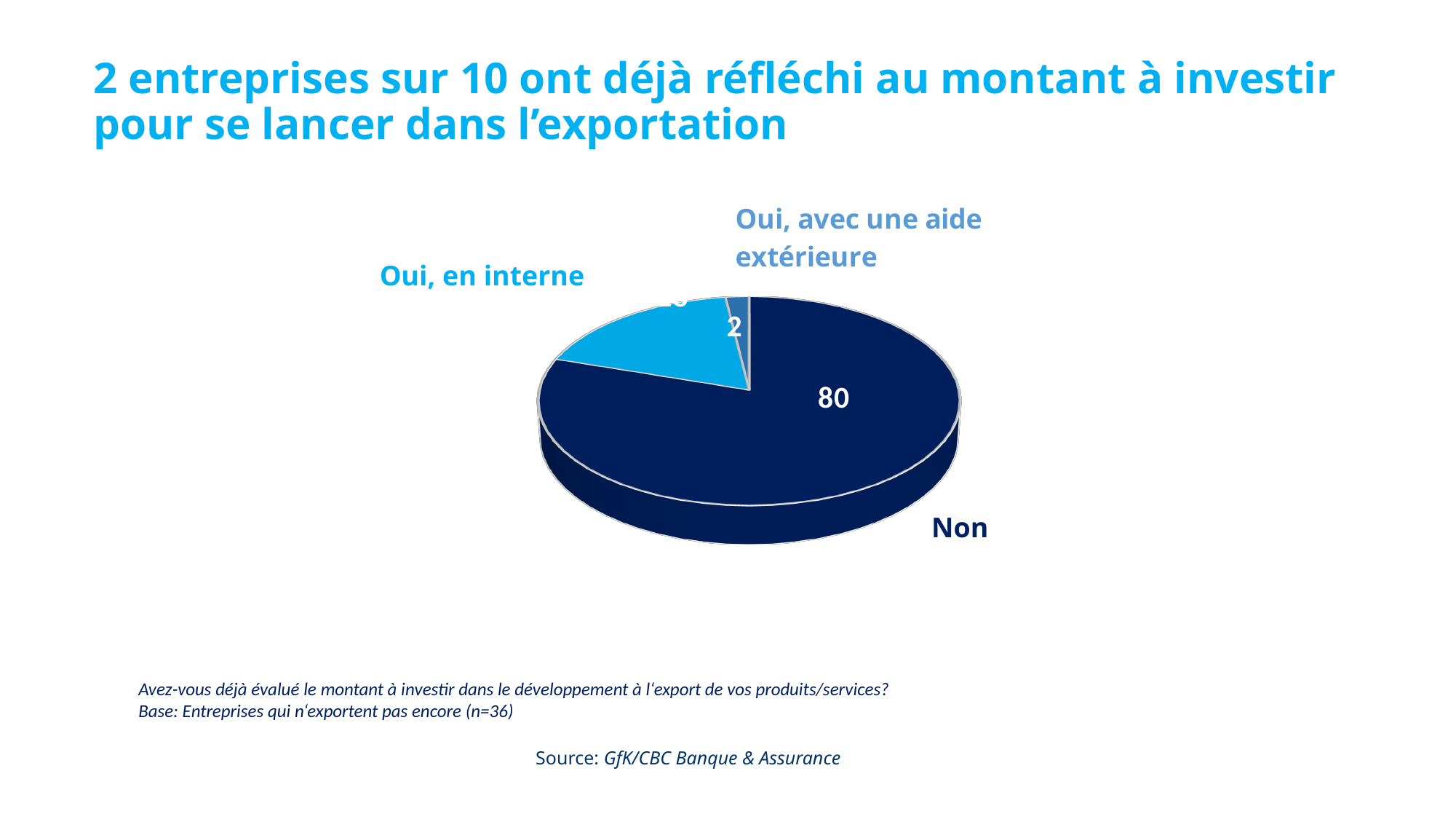
Which is larger: the slice for "Oui, en interne" or the slice for "Oui, avec une aide extérieure"? Oui, en interne How many categories (slices) does the pie chart have? 3 Which is larger: the slice for "Non" or the slice for "Oui, en interne"? Non What is the value shown for the "Non" slice? 80 What kind of chart is shown on the slide? pie chart What is the value shown for the "Oui, avec une aide extérieure" slice? 2 What is the difference between the value for "Non" and the value for "Oui, avec une aide extérieure"? 78 What colour is the "Non" slice of the pie? dark navy blue What is the title of the slide? 2 entreprises sur 10 ont déjà réfléchi au montant à investir pour se lancer dans l'exportation Which category has the smallest slice of the pie? Oui, avec une aide extérieure Which category has the largest slice of the pie? Non